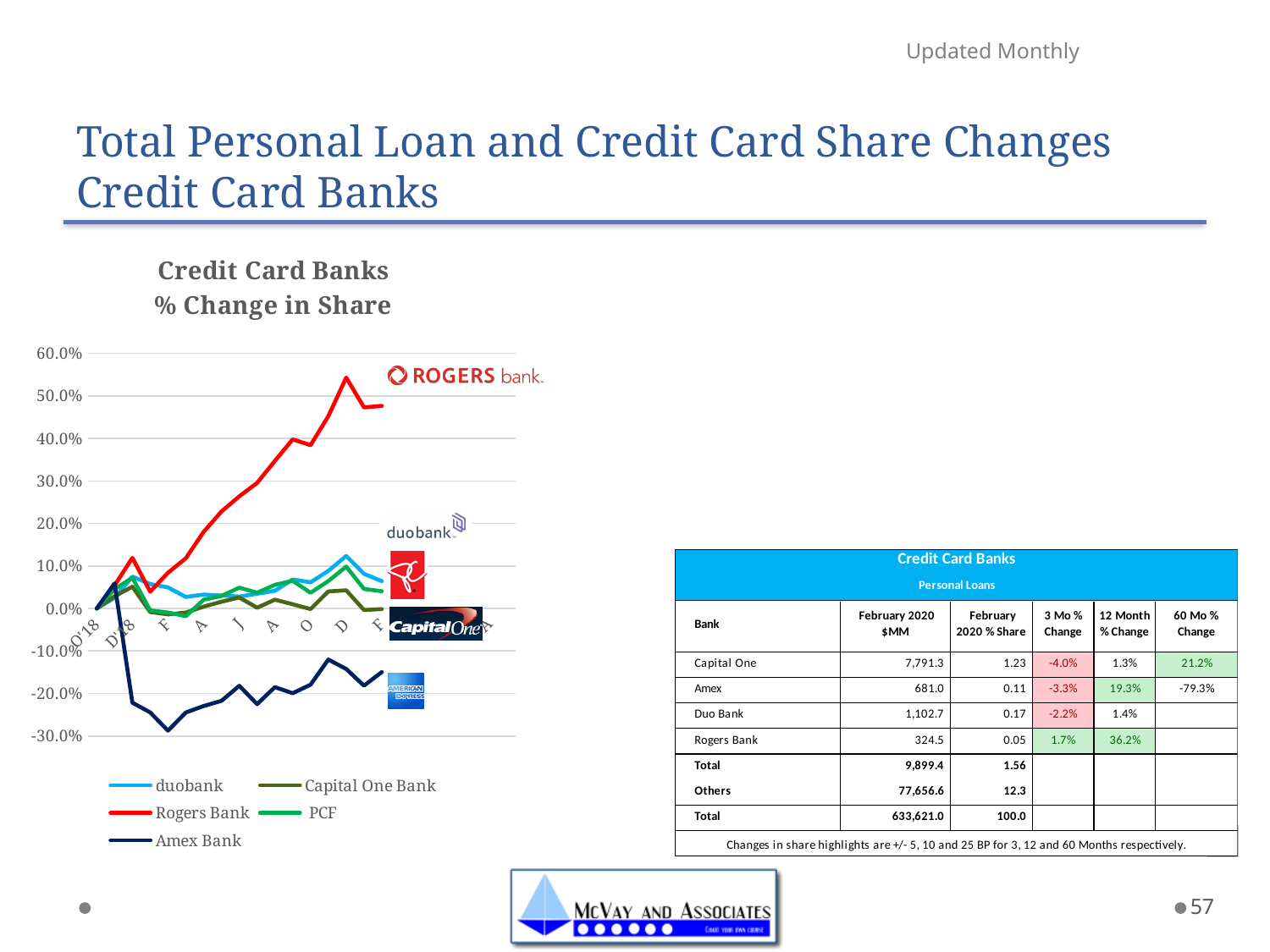
What is the title of the chart? Credit Card Banks % Change in Share Which series reaches the highest value on the chart? Rogers Bank Which series reaches the lowest value on the chart? Amex Bank Is the lowest value for Amex Bank greater or less than -20.0%? less At the end of the series, which is larger: Rogers Bank or duobank? Rogers Bank Which series is drawn in red on the chart? Rogers Bank Is the peak value for Rogers Bank greater or less than 50.0%? greater Is the final value for Rogers Bank greater or less than 40.0%? greater What kind of chart is shown on the slide? line chart How many series does the chart legend list? 5 Does the Amex Bank line rise or fall overall along the x axis? falls Does the Rogers Bank line rise or fall overall along the x axis? rises